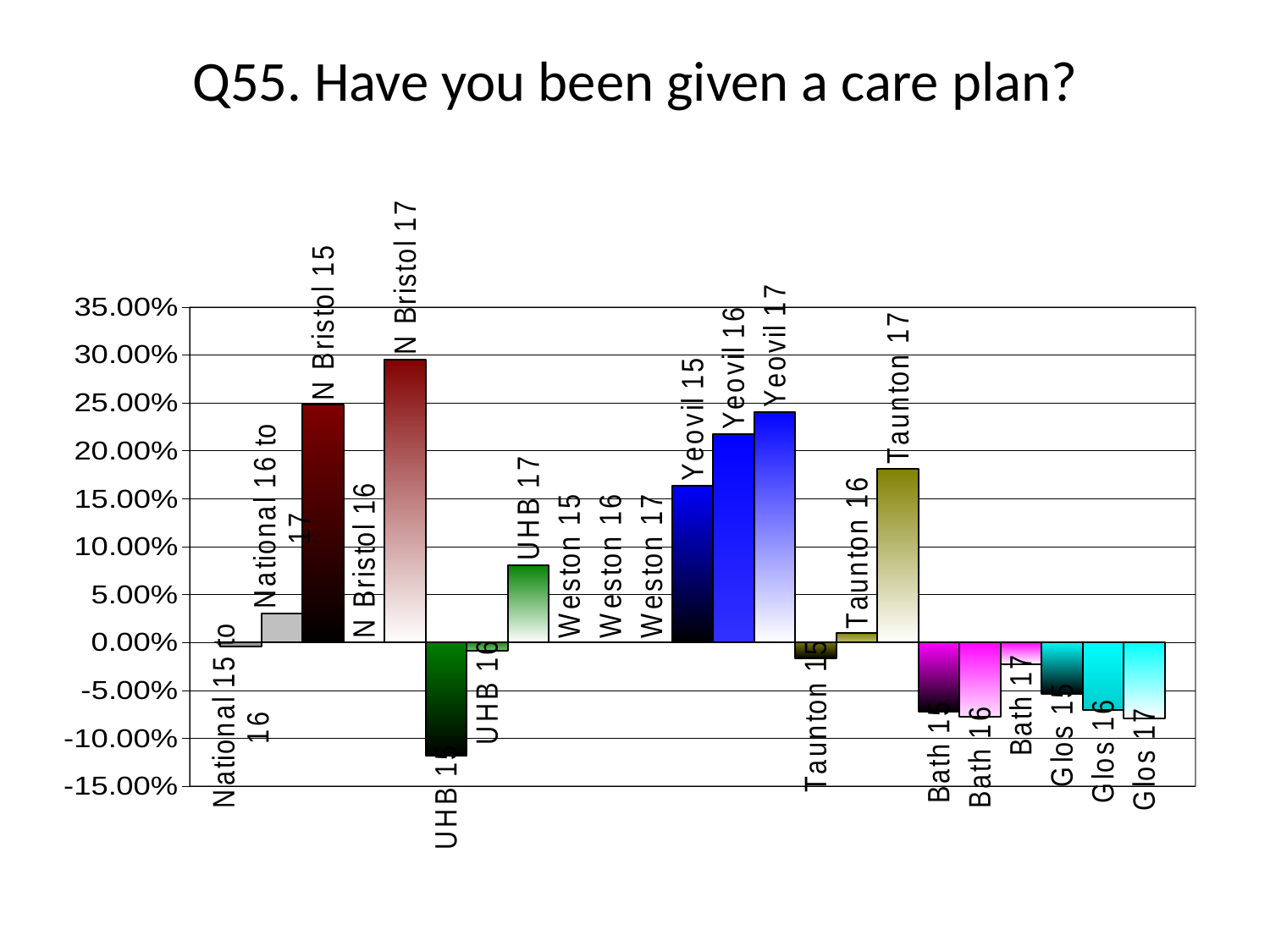
What kind of chart is shown on the slide? bar chart Which is larger, the value for Yeovil 17 or the value for Yeovil 15? Yeovil 17 Which category has the highest value? N Bristol 17 Which category has the lowest value? UHB 15 What is the title of the chart? Q55. Have you been given a care plan? Is the value for Yeovil 16 greater or less than 20.00%? greater Which is larger, the value for N Bristol 15 or the value for Taunton 17? N Bristol 15 Is the value for N Bristol 17 greater or less than 25.00%? greater Do the values for Yeovil rise or fall from Yeovil 15 to Yeovil 17? rise Is the value for Taunton 17 greater or less than 20.00%? less